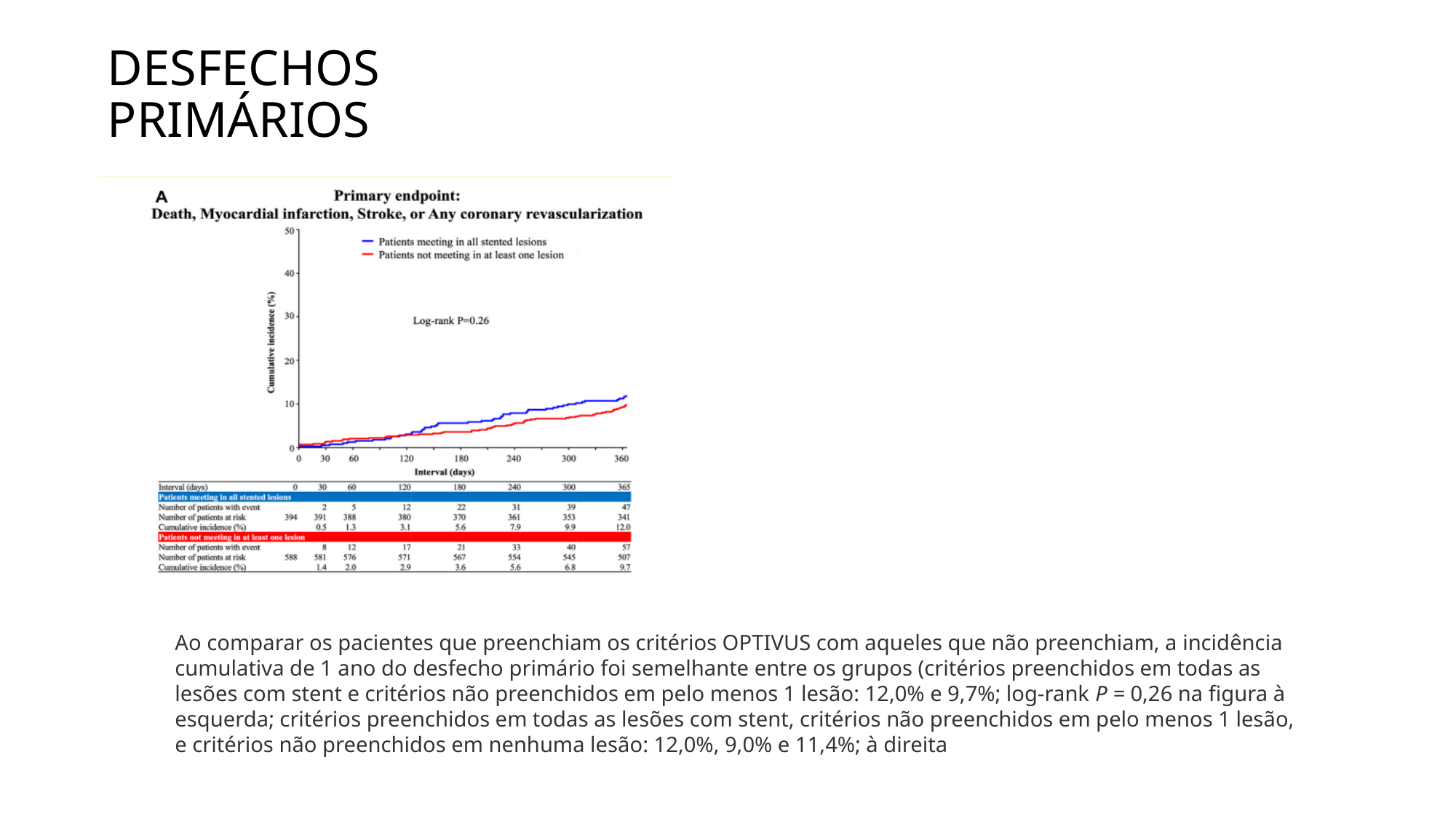
How many patients with event were recorded at 180 days in the group meeting in all stented lesions? 22 What is the label of the y axis of the chart? Cumulative incidence (%) What is the cumulative incidence (%) at 365 days for patients not meeting in at least one lesion? 9.7 Which group has the higher cumulative incidence at 365 days: patients meeting in all stented lesions or patients not meeting in at least one lesion? Patients meeting in all stented lesions Is the cumulative incidence of the blue line at 360 days greater or less than 10? greater What log-rank P value is printed on the chart? P=0.26 What is the difference in cumulative incidence (%) at 365 days between patients meeting in all stented lesions and patients not meeting in at least one lesion? 2.3 Do the cumulative incidence curves rise or fall as the interval in days increases? Rise What is the cumulative incidence (%) at 365 days for patients meeting in all stented lesions? 12.0 What kind of chart is shown on the slide? Line chart How many patients were at risk at day 0 in the group not meeting in at least one lesion? 588 How many series does the legend of the chart list? 2